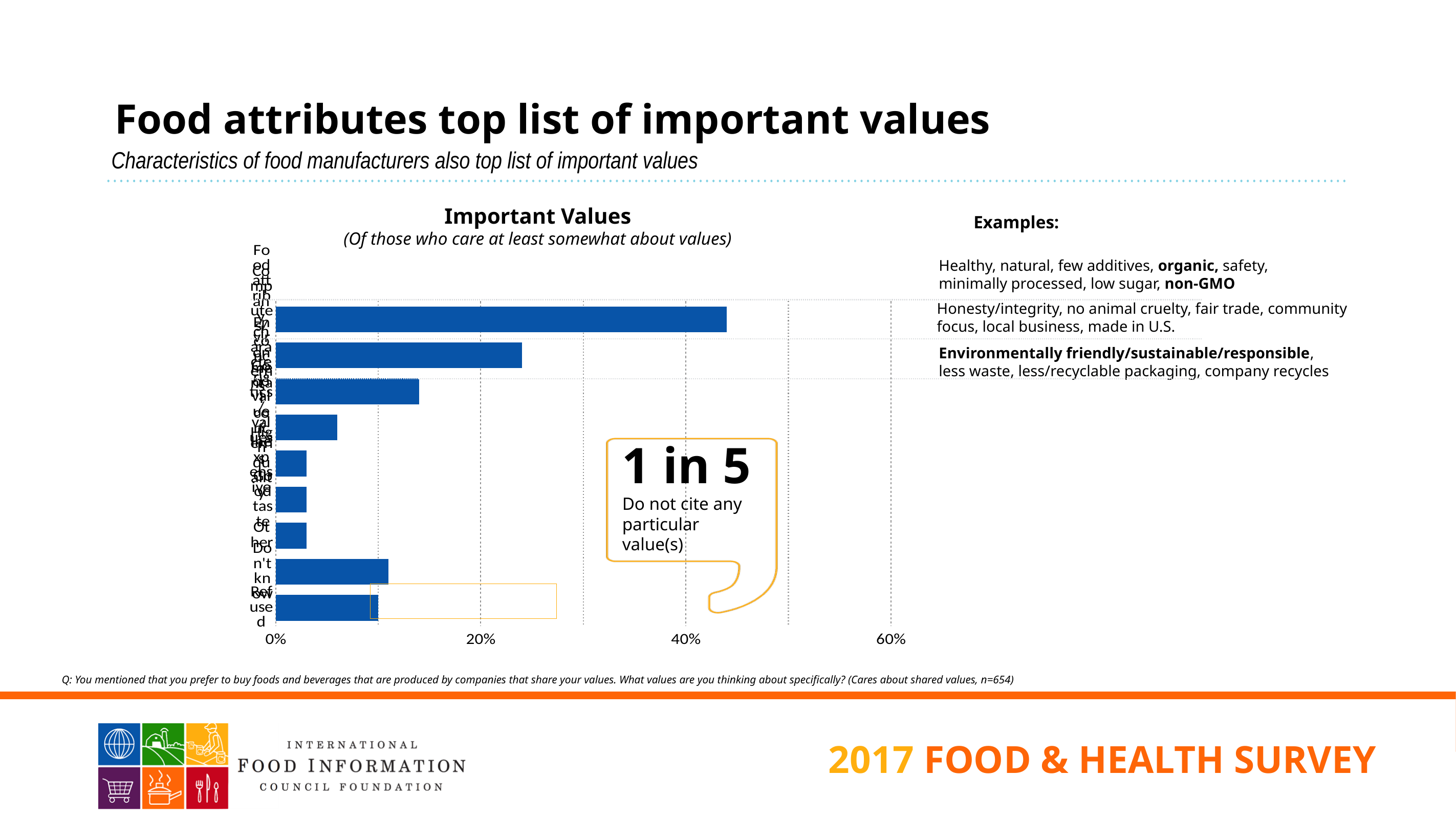
Is the value of the second bar from the top greater or less than 20%? greater What figure is highlighted in the callout box inside the chart area? 1 in 5 How many bars are plotted in the Important Values chart? 9 Is the value of the third bar from the top greater or less than 20%? less Which bar in the chart is the longest? the top (first) bar Is the value of the top (first) bar greater or less than 40%? greater What kind of chart is shown on the slide? bar chart What is the title of the chart? Important Values Which is larger, the top bar or the second bar from the top? the top bar Which is larger, the second bar from the top or the third bar from the top? the second bar